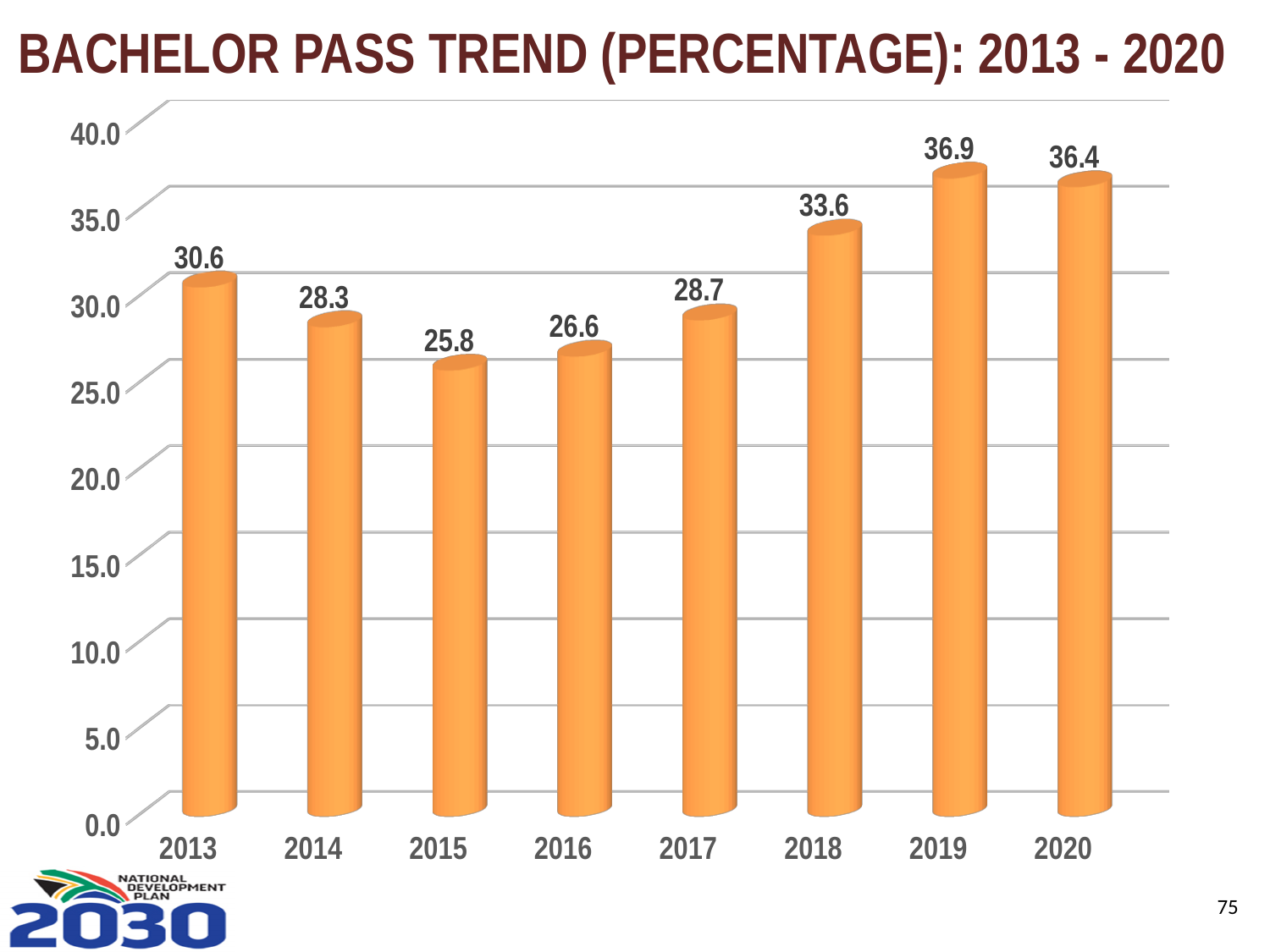
How many years are shown on the chart? 8 What is the bachelor pass percentage for 2018? 33.6 Which year has a higher bachelor pass percentage, 2014 or 2017? 2017 Is the value for 2016 greater or less than 30.0? less What is the title of the chart? BACHELOR PASS TREND (PERCENTAGE): 2013 - 2020 Which year has the lowest bachelor pass percentage? 2015 What is the difference between the bachelor pass percentage in 2020 and in 2019? 0.5 What is the bachelor pass percentage for 2013? 30.6 What is the difference between the bachelor pass percentage in 2019 and in 2013? 6.3 Which year has the highest bachelor pass percentage? 2019 What is the bachelor pass percentage for 2015? 25.8 What kind of chart is shown on the slide? Bar chart